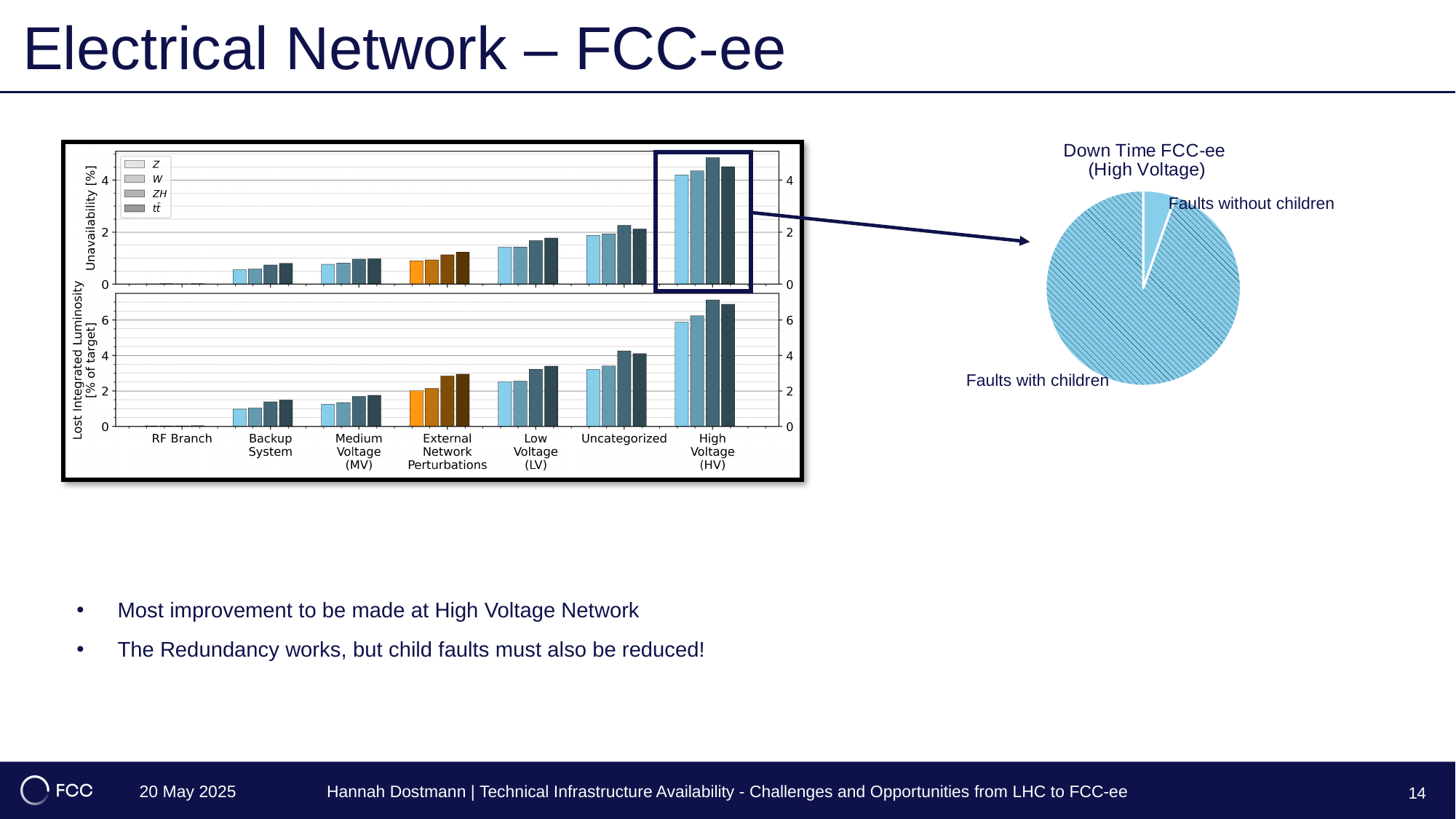
In the bar chart on the left, is the Unavailability [%] for High Voltage (HV) in the Z series greater or less than 4? greater In the pie chart on the right, which slice is larger: Faults with children or Faults without children? Faults with children What kind of chart is the chart on the left of the slide? bar chart What kind of chart is the chart on the right of the slide? pie chart How many categories are shown on the x axis of the bar chart on the left? 7 In the bar chart on the left, which category has the highest Unavailability [%]? High Voltage (HV) How many series does the legend of the bar chart on the left list? 4 In the bar chart on the left, which category has the lowest Lost Integrated Luminosity? RF Branch In the bar chart on the left, do the Unavailability [%] values generally rise or fall from RF Branch to High Voltage (HV)? rise In the bar chart on the left, is the Lost Integrated Luminosity for Backup System in the Z series greater or less than 2? less What is the title of the pie chart on the right? Down Time FCC-ee (High Voltage) In the bar chart on the left, is the Unavailability [%] for Low Voltage (LV) in the tt̄ series greater or less than 2? less